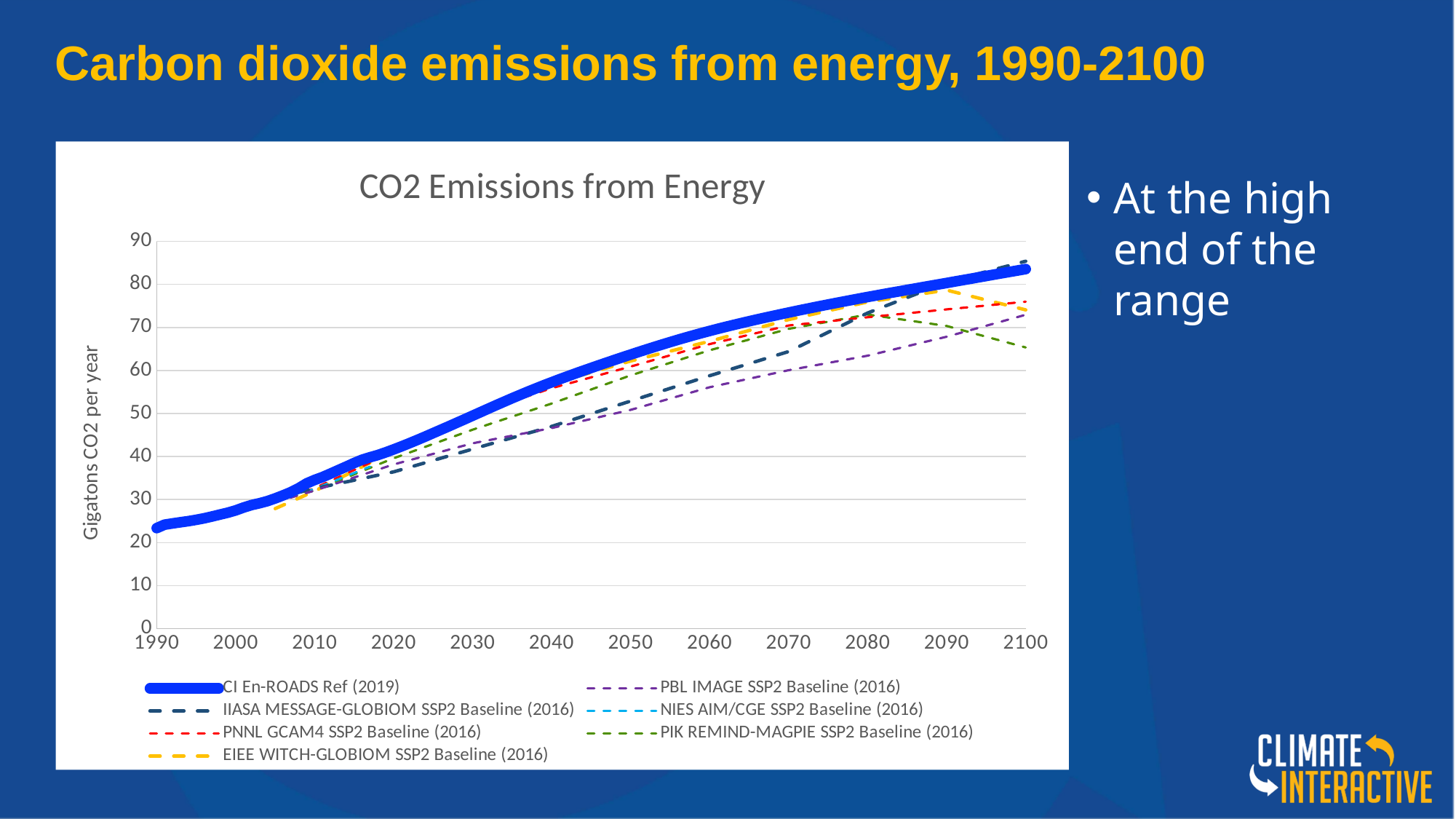
In 2100, which is higher: CI En-ROADS Ref (2019) or PIK REMIND-MAGPIE SSP2 Baseline (2016)? CI En-ROADS Ref (2019) How many year labels are shown on the horizontal axis? 12 What is the title of the chart? CO2 Emissions from Energy What kind of chart is shown on the slide? Line chart Does the CI En-ROADS Ref (2019) line rise or fall from 1990 to 2100? Rise Is the value for CI En-ROADS Ref (2019) in 1990 greater or less than 30? less Is the value for PIK REMIND-MAGPIE SSP2 Baseline (2016) in 2100 greater or less than 70? less In 2060, which is higher: CI En-ROADS Ref (2019) or PBL IMAGE SSP2 Baseline (2016)? CI En-ROADS Ref (2019) Is the value for CI En-ROADS Ref (2019) in 2100 greater or less than 80? greater How many series does the chart legend list? 7 Which series has the lowest value in 2100? PIK REMIND-MAGPIE SSP2 Baseline (2016) What is the label on the vertical axis of the chart? Gigatons CO2 per year